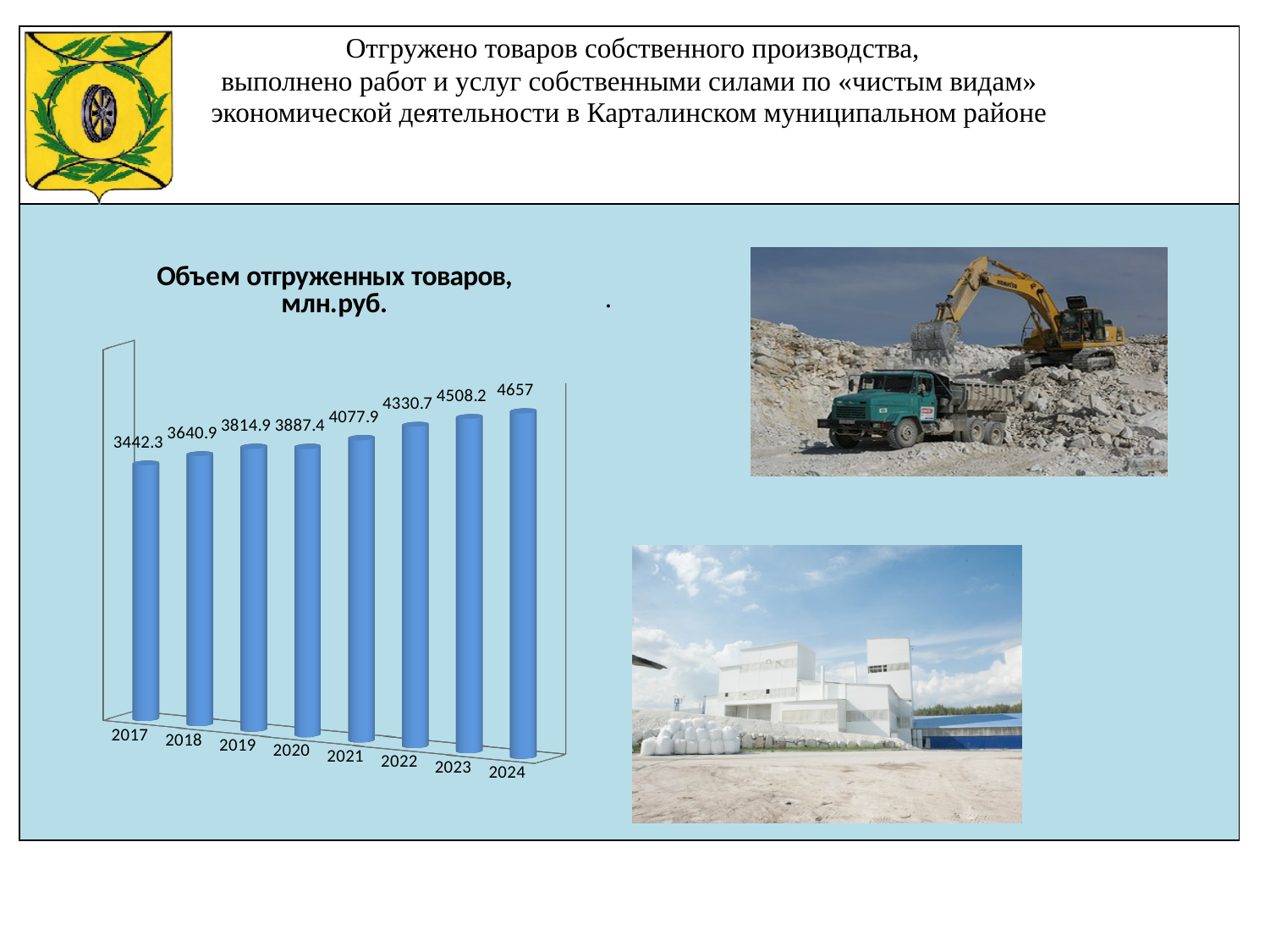
Which year has the highest value in the chart? 2024 What is the value for 2017 in the chart? 3442.3 Do the values rise or fall from 2017 to 2024? rise What is the difference between the values for 2023 and 2022? 177.5 What is the value for 2024 in the chart? 4657 What is the value for 2021 in the chart? 4077.9 What is the title of the chart? Объем отгруженных товаров, млн.руб. What is the difference between the values for 2024 and 2017? 1214.7 Which year has the lowest value in the chart? 2017 How many years are shown in the chart? 8 What kind of chart is shown on the slide? bar chart Which is larger, the value for 2019 or the value for 2020? 2020